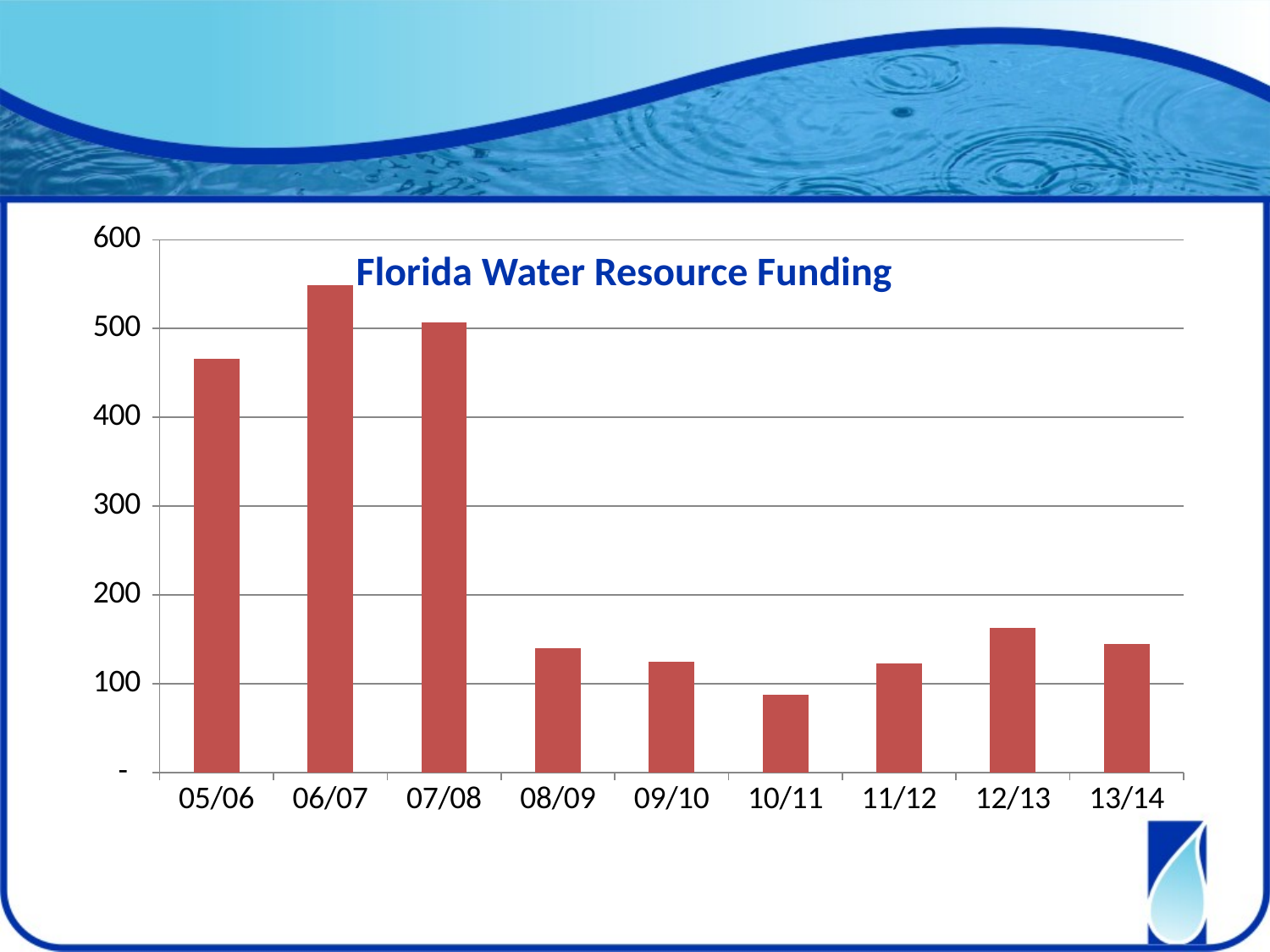
Is the value for 10/11 greater or less than 100? less Which fiscal year has the lowest funding value? 10/11 Is the value for 12/13 greater or less than 200? less Is the value for 05/06 greater or less than 400? greater What kind of chart is shown on the slide? bar chart What is the title of the chart? Florida Water Resource Funding How many fiscal years are shown on the x axis of the chart? 9 Which is larger, the value for 12/13 or the value for 13/14? 12/13 Which is larger, the value for 05/06 or the value for 07/08? 07/08 Which fiscal year has the highest funding value? 06/07 Do the values rise or fall from 07/08 to 10/11? fall